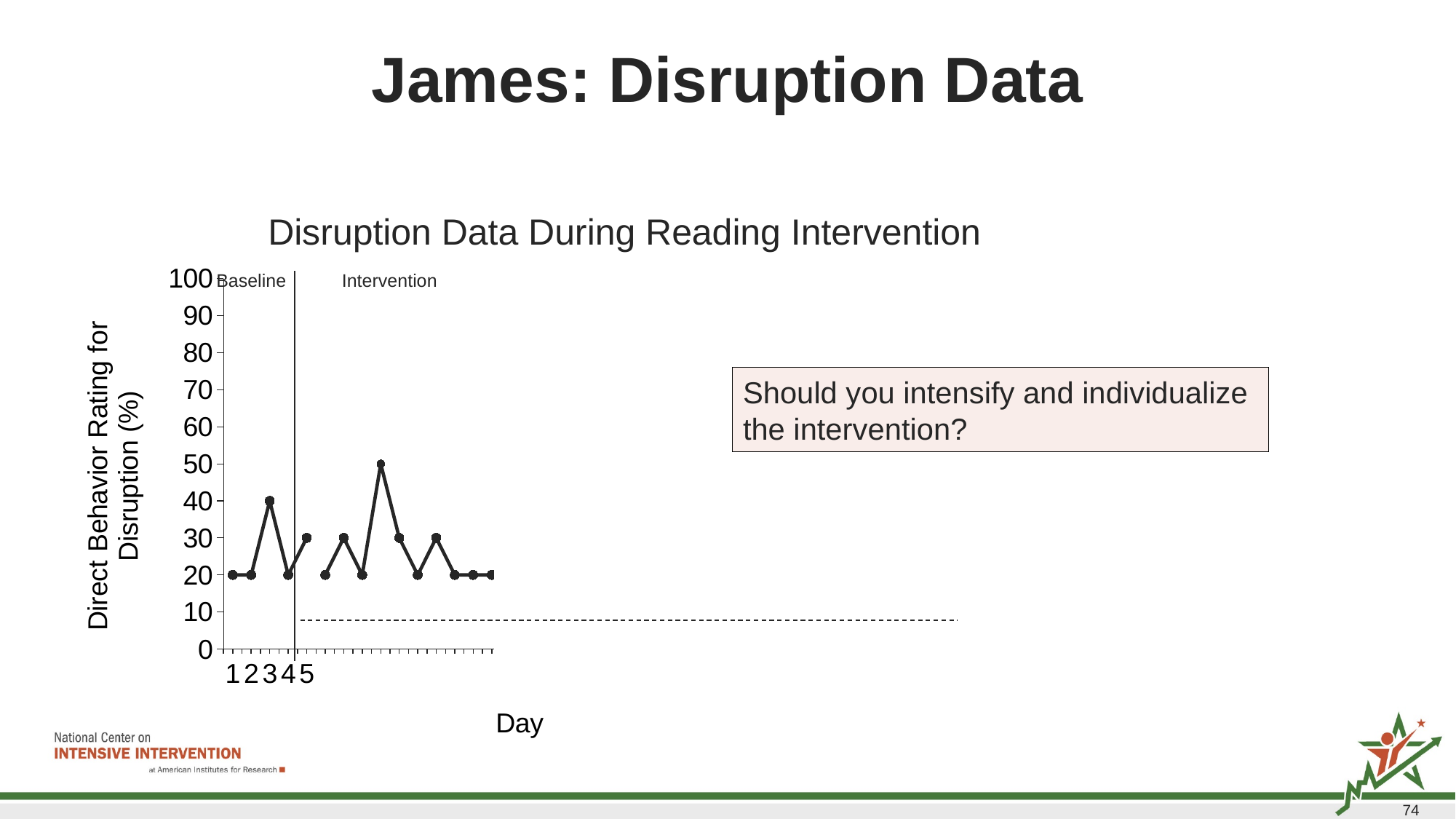
What is the Direct Behavior Rating for Disruption on Day 1? 20 How many data points are plotted in the Baseline phase? 5 What is the highest Direct Behavior Rating for Disruption plotted on the chart? 50 What type of chart is shown on the slide? line chart What is the Direct Behavior Rating for Disruption on Day 5? 30 What is the title of the chart? Disruption Data During Reading Intervention What is the Direct Behavior Rating for Disruption on Day 3? 40 What is the difference between the disruption rating on Day 3 and on Day 1? 20 Which day has the higher disruption rating, Day 3 or Day 4? Day 3 Is the highest disruption rating in the Intervention phase greater or less than 60? less What is the lowest Direct Behavior Rating for Disruption plotted on the chart? 20 What is the label of the vertical axis of the chart? Direct Behavior Rating for Disruption (%)